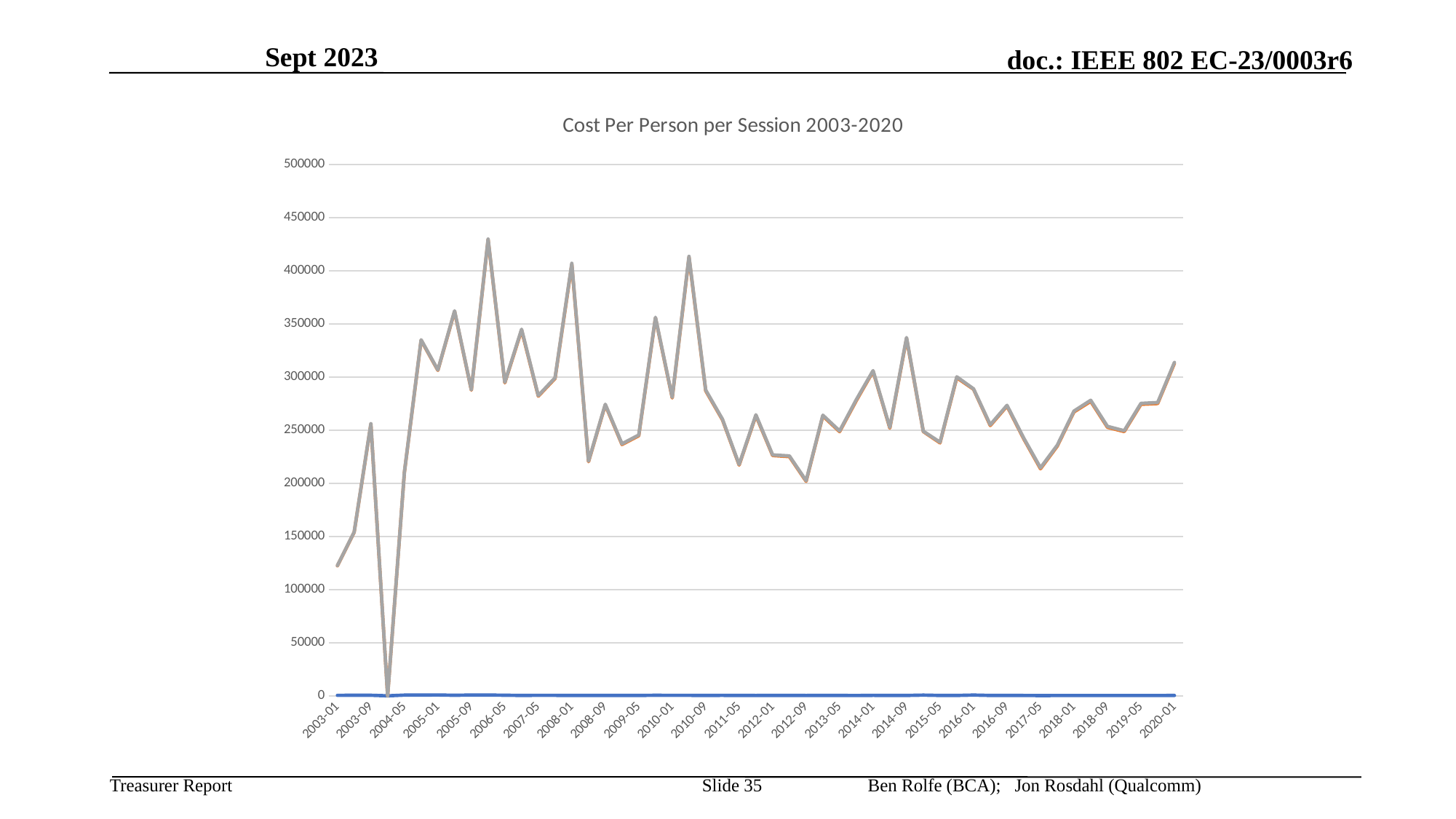
Is the value for 2003-01 greater or less than 150000? less What kind of chart is shown on the slide? line chart Is the value for 2012-09 greater or less than 250000? less Is the value for 2008-01 greater or less than 350000? greater How many session labels are shown on the x axis? 26 Which is larger, the value for 2003-01 or the value for 2020-01? 2020-01 What is the title of the chart? Cost Per Person per Session 2003-2020 Which is larger, the value for 2008-01 or the value for 2012-09? 2008-01